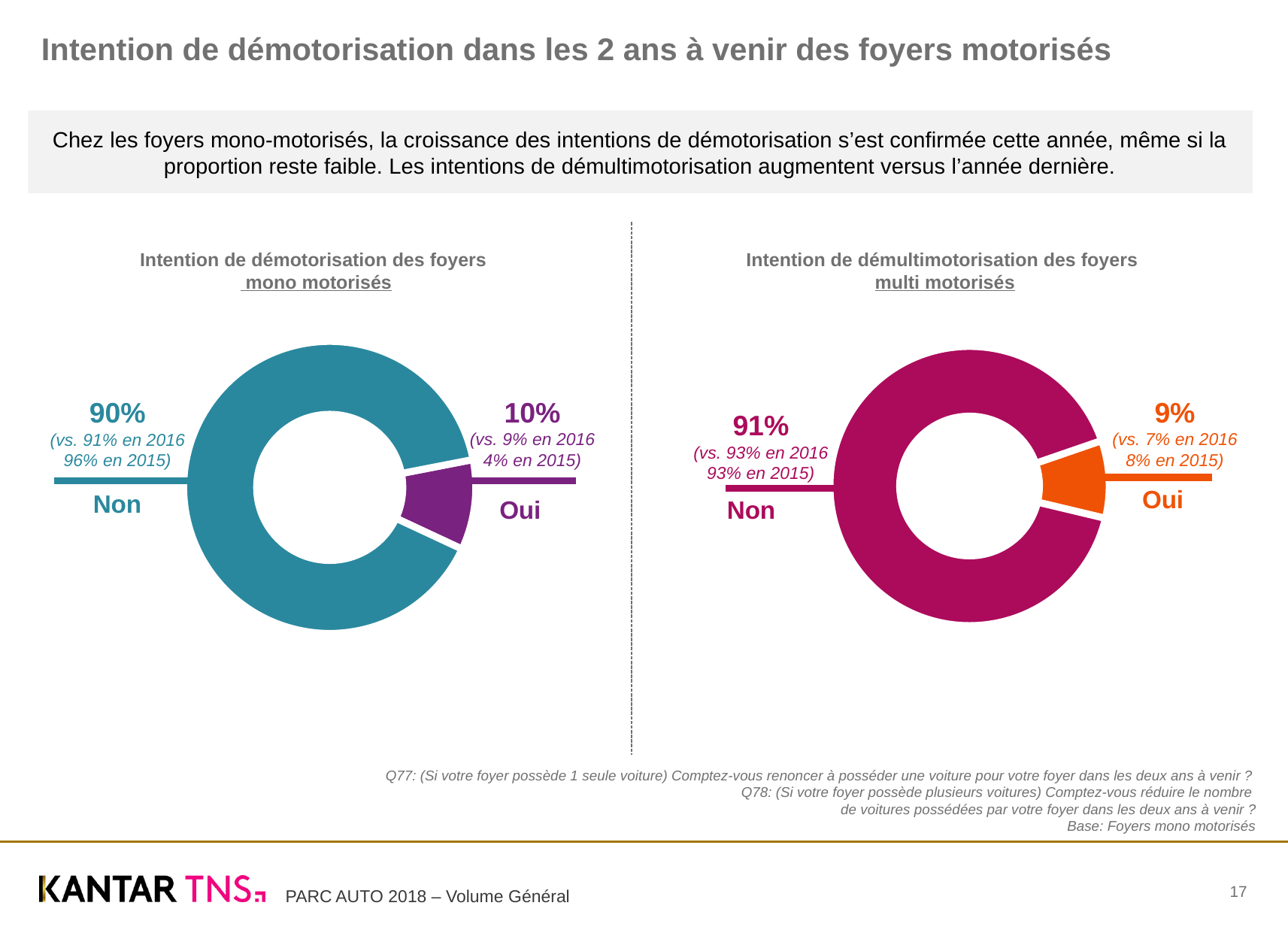
In the left chart (mono motorisés), what is the difference between Non and Oui? 80 percentage points What kind of chart is used on the left (mono motorisés)? Doughnut (pie) chart In the left chart (Intention de démotorisation des foyers mono motorisés), what is the value for Oui? 10% In the left chart (mono motorisés), what colour is the Oui slice? Purple In the right chart (multi motorisés), which category is the smallest? Oui In the left chart (mono motorisés), which category is the largest? Non How many categories does the right chart (multi motorisés) show? 2 Which is larger: Oui in the left chart (mono motorisés) or Oui in the right chart (multi motorisés)? Oui in the left chart (10%) In the right chart (Intention de démultimotorisation des foyers multi motorisés), what is the value for Oui? 9% In the right chart (Intention de démultimotorisation des foyers multi motorisés), what is the value for Non? 91% In the right chart (multi motorisés), what is the difference between Non and Oui? 82 percentage points In the left chart (Intention de démotorisation des foyers mono motorisés), what is the value for Non? 90%